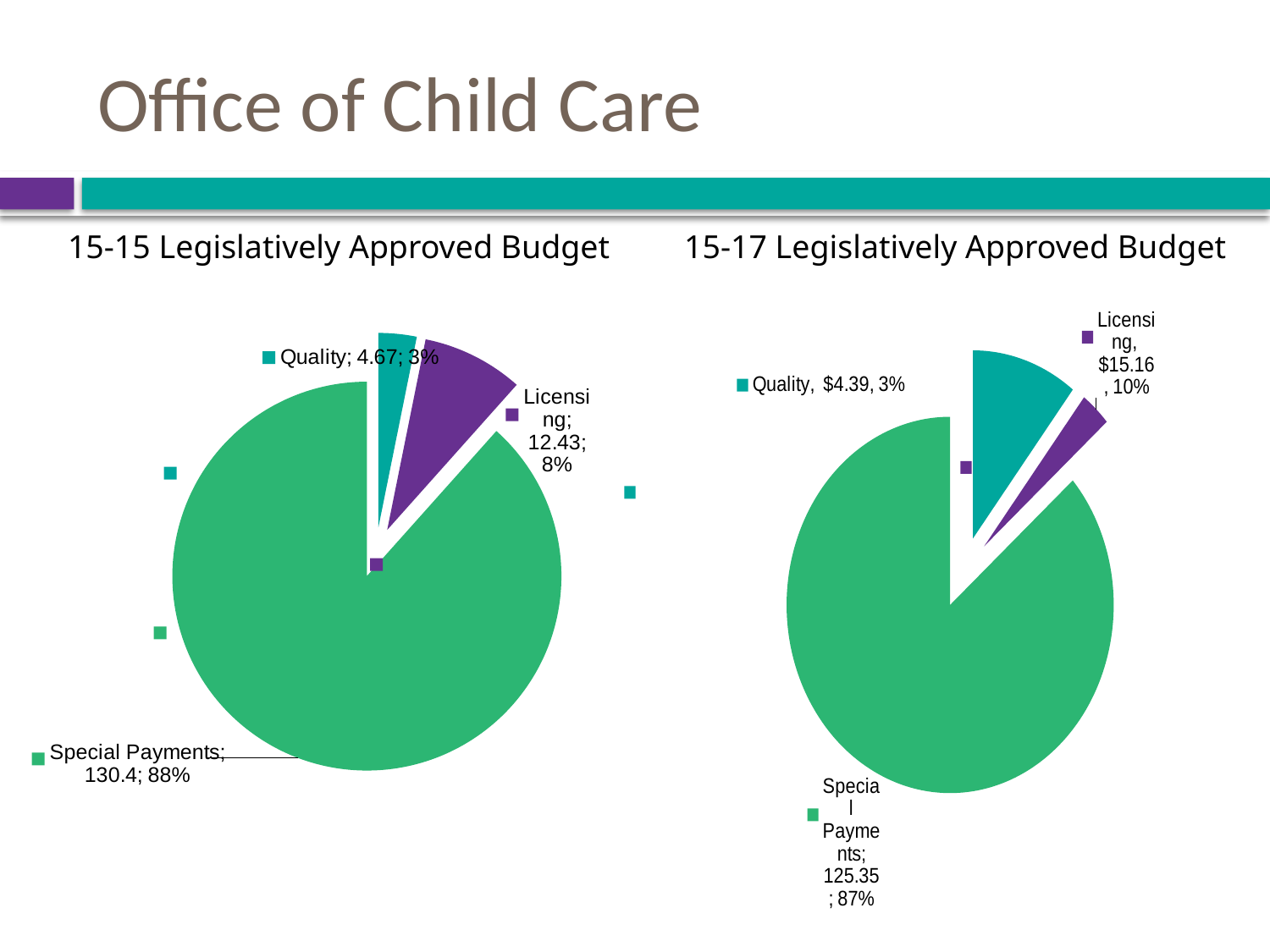
How many slices does the right chart (15-17 Legislatively Approved Budget) have? 3 What kind of chart is the left chart titled "15-15 Legislatively Approved Budget"? Pie chart In the left chart (15-15 Legislatively Approved Budget), which category has the largest slice? Special Payments In the right chart (15-17 Legislatively Approved Budget), what is the difference between the Special Payments value and the Licensing value? 110.19 In the right chart (15-17 Legislatively Approved Budget), what share of the pie is Special Payments? 87% In the left chart (15-15 Legislatively Approved Budget), which category has the smallest slice? Quality In the left chart (15-15 Legislatively Approved Budget), what value is shown for Quality? 4.67 In the right chart (15-17 Legislatively Approved Budget), what value is shown for Quality? $4.39 In the right chart (15-17 Legislatively Approved Budget), which is larger, Licensing or Quality? Licensing In the right chart (15-17 Legislatively Approved Budget), what value is shown for Licensing? $15.16 In the left chart (15-15 Legislatively Approved Budget), what value is shown for Special Payments? 130.4 In the left chart (15-15 Legislatively Approved Budget), what share of the pie is Licensing? 8%